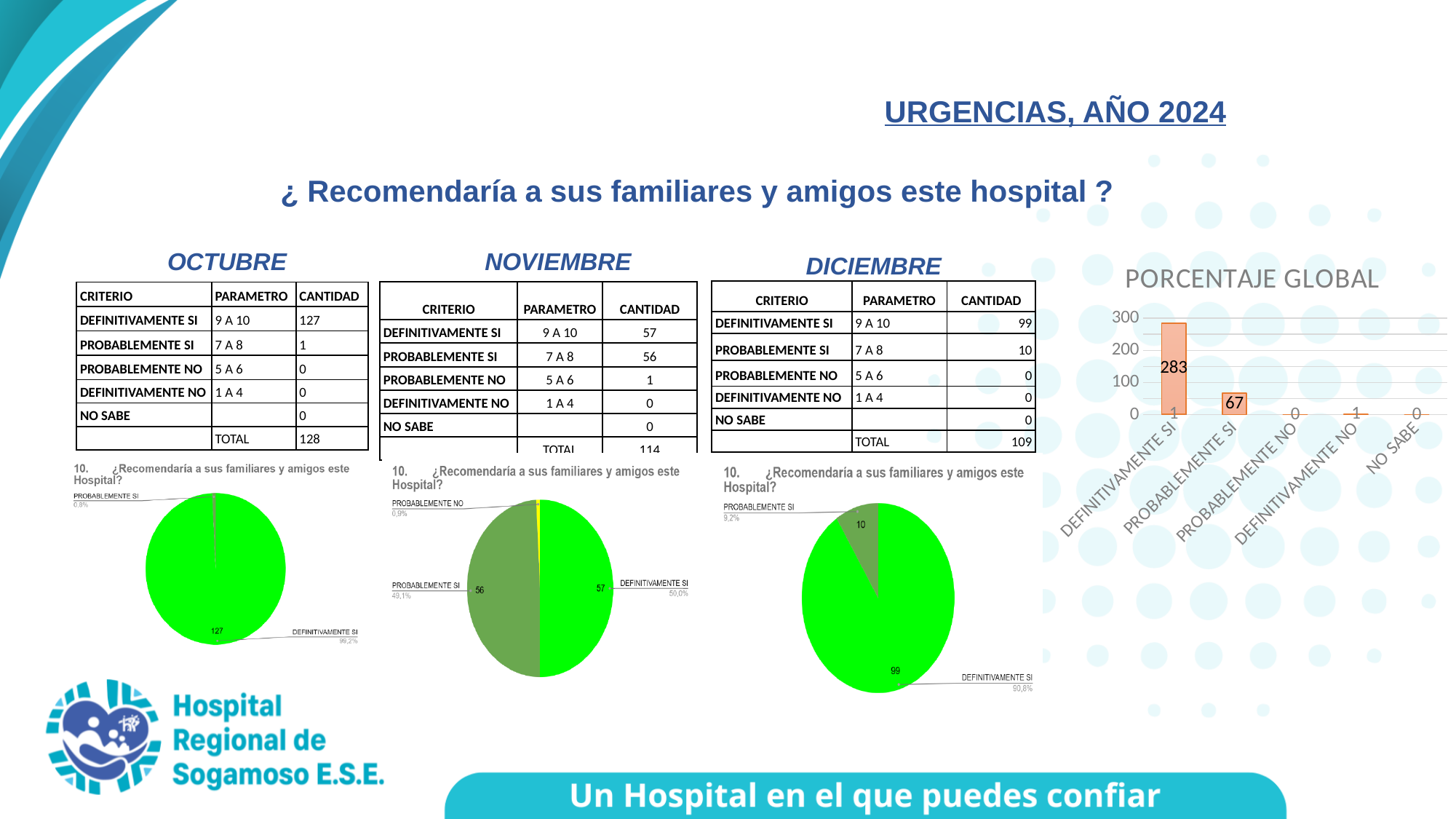
In the OCTUBRE pie chart, what share does DEFINITIVAMENTE SI have? 99,2% In the PORCENTAJE GLOBAL bar chart, what is the difference between the values for DEFINITIVAMENTE SI and PROBABLEMENTE SI? 216 In the PORCENTAJE GLOBAL bar chart, which category has the highest value? DEFINITIVAMENTE SI In the DICIEMBRE pie chart, what is the value for DEFINITIVAMENTE SI? 99 What kind of chart is the PORCENTAJE GLOBAL chart? bar chart In the PORCENTAJE GLOBAL bar chart, what is the value for DEFINITIVAMENTE SI? 283 In the PORCENTAJE GLOBAL bar chart, what is the value for PROBABLEMENTE SI? 67 In the NOVIEMBRE pie chart, what share does DEFINITIVAMENTE SI have? 50,0% In the NOVIEMBRE pie chart, what is the value for PROBABLEMENTE SI? 56 In the PORCENTAJE GLOBAL bar chart, is the value for DEFINITIVAMENTE SI greater or less than 200? greater How many categories are shown on the x axis of the PORCENTAJE GLOBAL bar chart? 5 In the DICIEMBRE pie chart, which is larger, DEFINITIVAMENTE SI or PROBABLEMENTE SI? DEFINITIVAMENTE SI